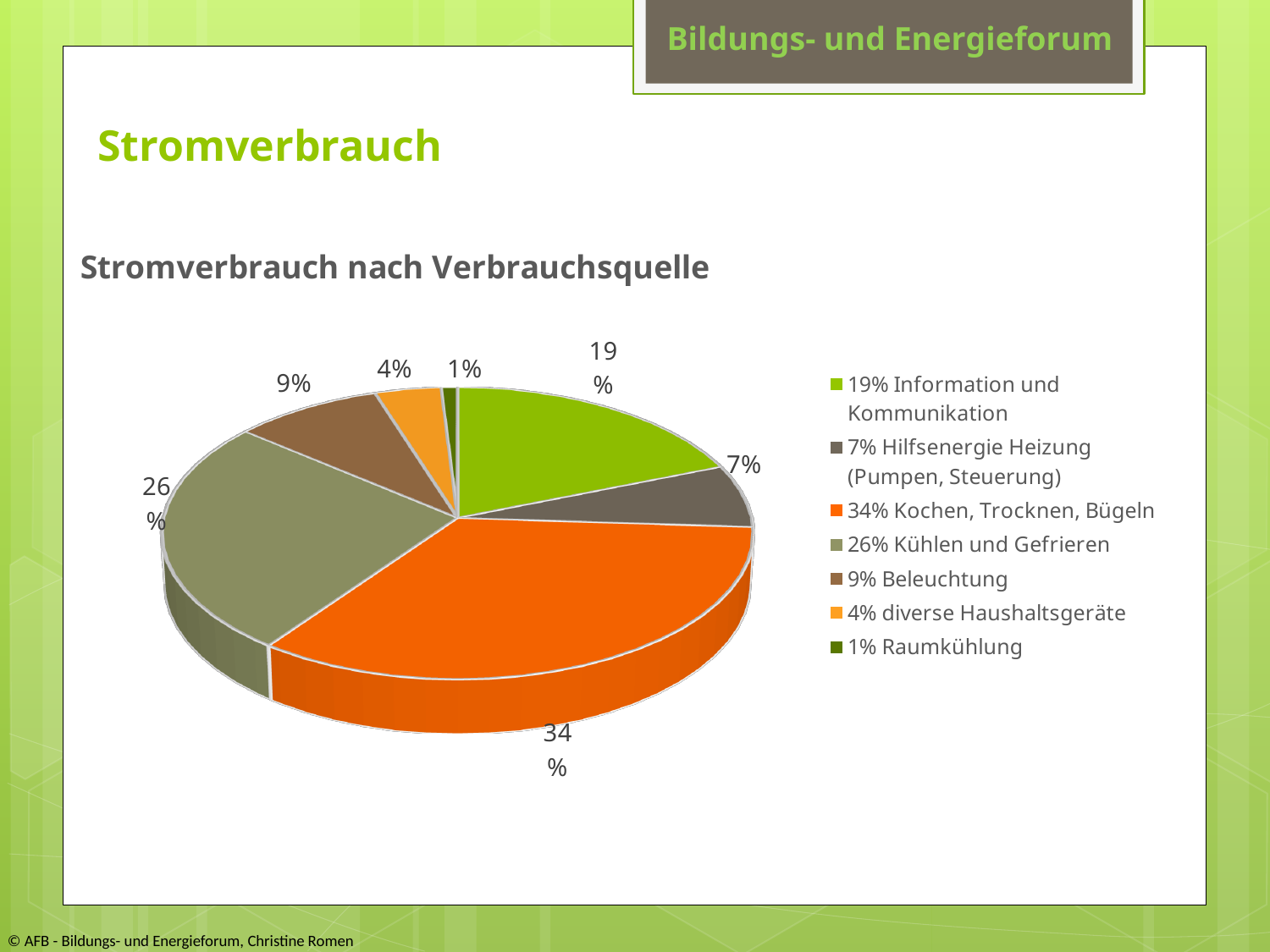
What colour is the slice for Kochen, Trocknen, Bügeln? orange What share of the pie is Information und Kommunikation? 19% What share of the pie is Beleuchtung? 9% What kind of chart is shown on the slide? pie chart What share of the pie is Kochen, Trocknen, Bügeln? 34% Which category has the smallest share of the pie? Raumkühlung What is the difference in percentage points between Kochen, Trocknen, Bügeln and Kühlen und Gefrieren? 8 How many slices does the pie chart have? 7 What is the title of the chart? Stromverbrauch nach Verbrauchsquelle Which is larger: the share for Hilfsenergie Heizung (Pumpen, Steuerung) or the share for diverse Haushaltsgeräte? Hilfsenergie Heizung (Pumpen, Steuerung) Which category has the largest share of the pie? Kochen, Trocknen, Bügeln